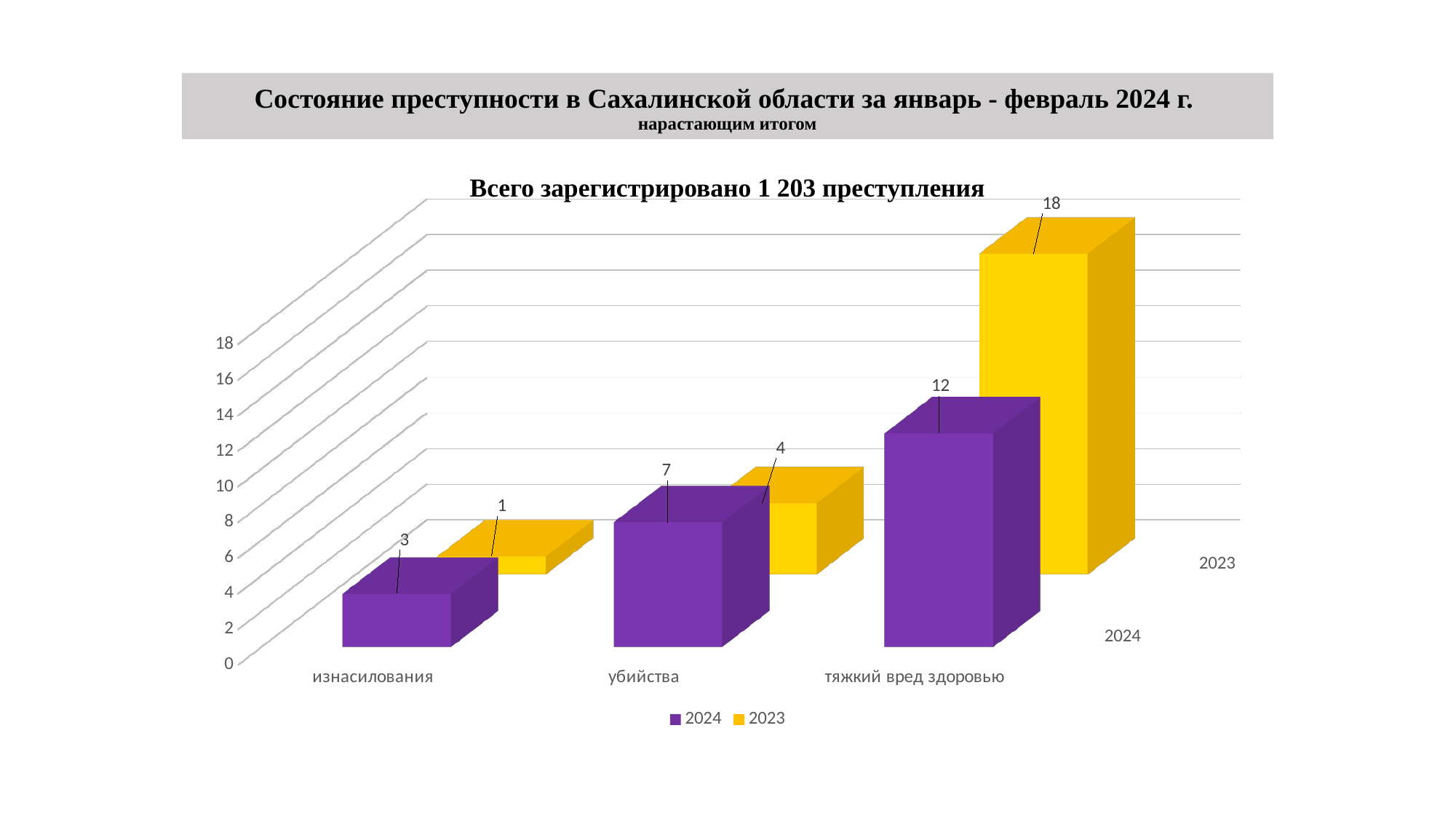
What is the difference between the 2023 and 2024 values for тяжкий вред здоровью? 6 What is the value for тяжкий вред здоровью in the 2023 series? 18 What is the value for тяжкий вред здоровью in the 2024 series? 12 Which category has the lowest value in the 2024 series? изнасилования How many series does the legend list? 2 What kind of chart is shown on the slide? bar chart What is the value for убийства in the 2023 series? 4 What is the title of the chart? Всего зарегистрировано 1 203 преступления Which category has the highest value in the 2023 series? тяжкий вред здоровью How many categories are shown on the x axis? 3 For убийства, which series has the larger value, 2024 or 2023? 2024 What is the value for изнасилования in the 2024 series? 3